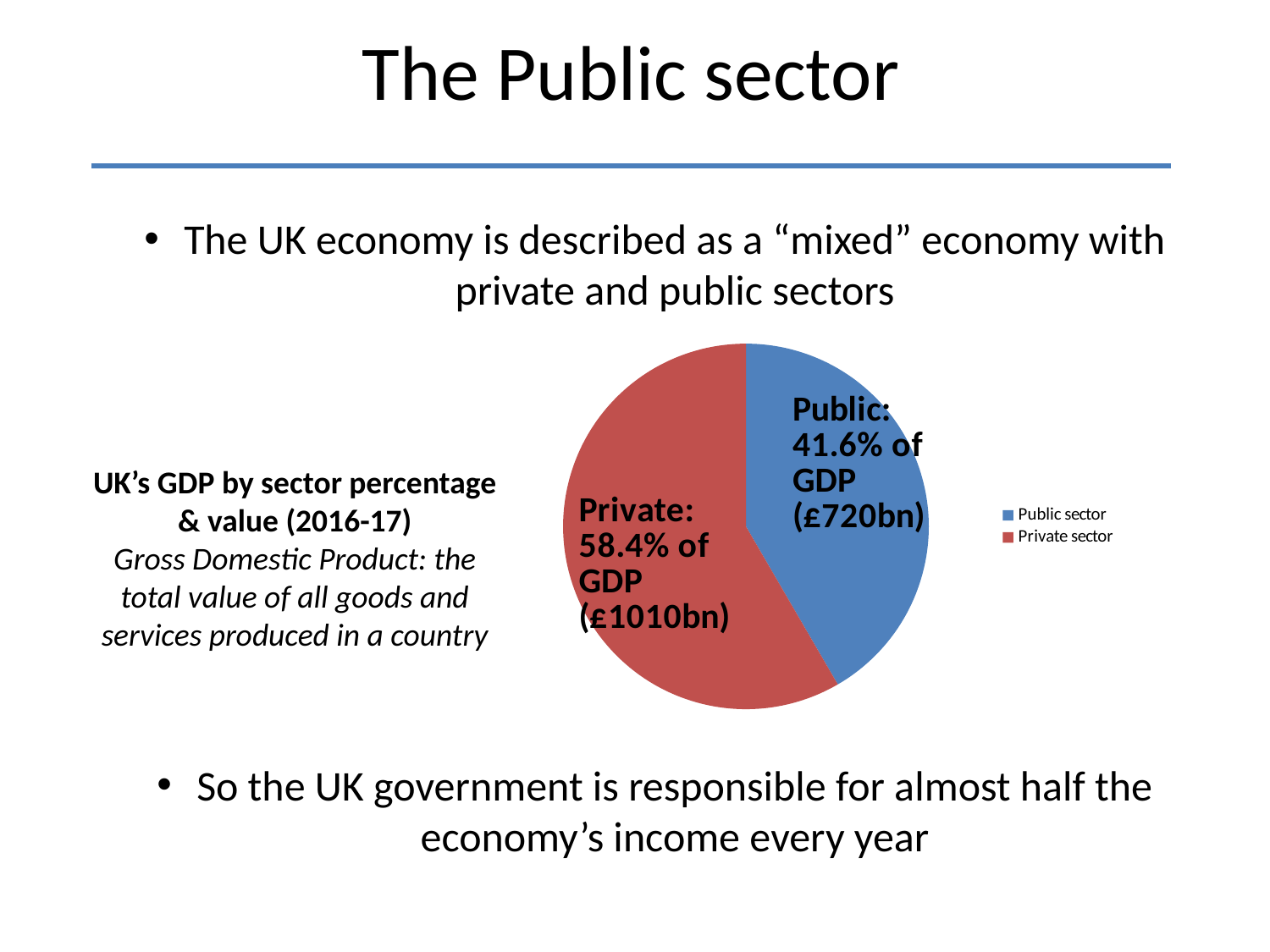
What kind of chart is shown on the slide? pie chart Which sector has the smaller share of GDP? Public sector What is the difference in £bn between the Private and Public sector values? £290bn What percentage of GDP does the Public sector slice represent? 41.6% What percentage of GDP does the Private sector slice represent? 58.4% How many entries does the legend list? 2 What colour is the Public sector slice? blue How many slices does the pie chart have? 2 What is the difference in percentage points between the Private and Public sector shares? 16.8 What value in £bn is shown for the Public sector? £720bn Which sector has the larger share of GDP? Private sector What value in £bn is shown for the Private sector? £1010bn